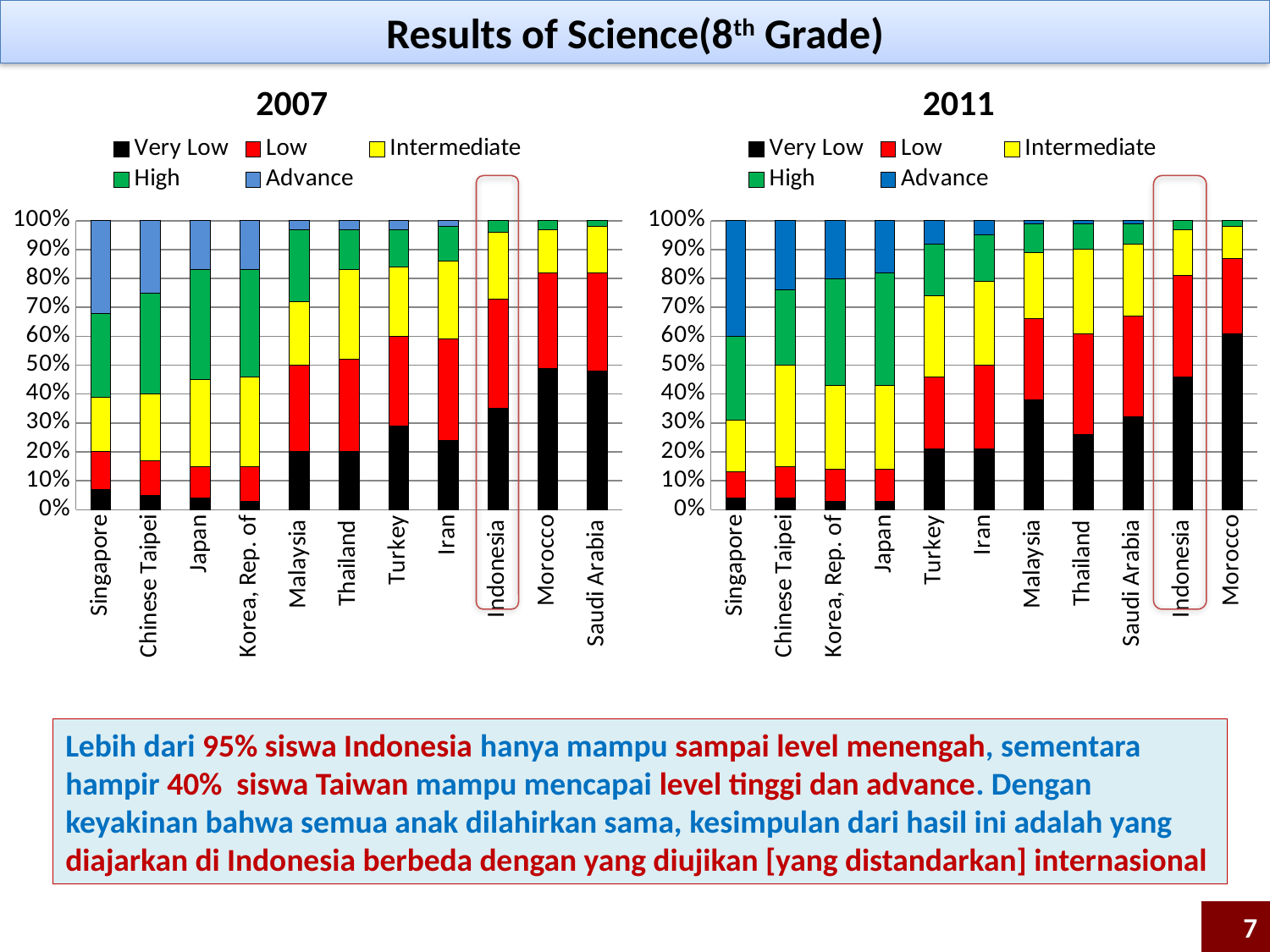
Which country is highlighted with a red outline on both charts? Indonesia On the 2007 chart, is the Very Low share for Singapore greater or less than 10%? less On the 2011 chart, is the Very Low share for Indonesia greater or less than 40%? greater On the 2011 chart, which country has the largest Very Low share? Morocco How many series does the legend of the 2007 chart list? 5 On the 2007 chart, is the Very Low share for Indonesia greater or less than 30%? greater How many countries are shown on the 2011 chart? 11 On the 2007 chart, which has the larger Very Low share, Morocco or Singapore? Morocco What kind of chart is the 2007 chart? Stacked bar chart What is the title of the chart on the left? 2007 On the 2011 chart, which has the larger Very Low share, Indonesia or Thailand? Indonesia